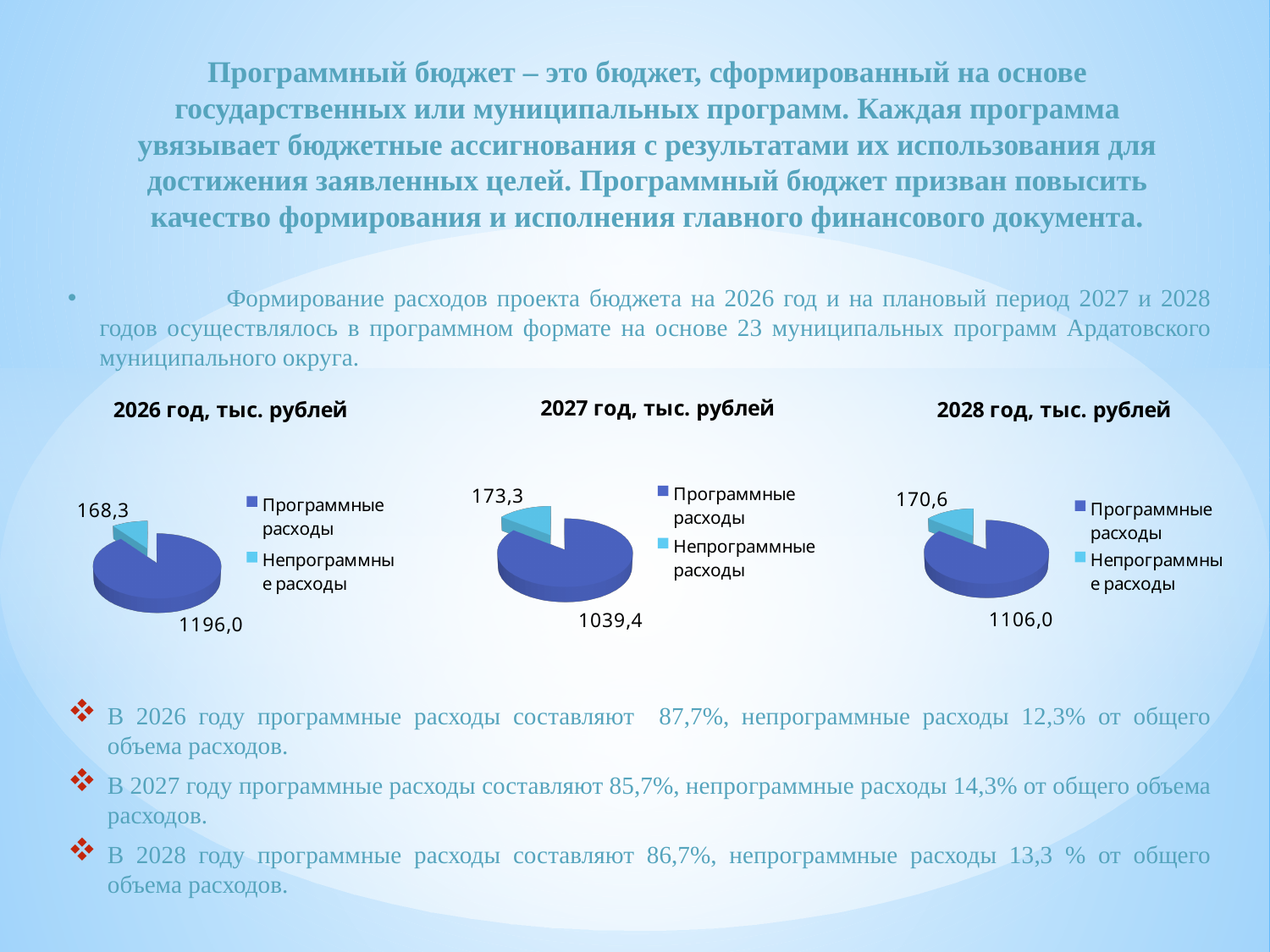
On the chart titled "2027 год, тыс. рублей", what is the value for Программные расходы? 1039,4 What kind of chart is the chart titled "2026 год, тыс. рублей"? pie chart On the chart titled "2027 год, тыс. рублей", what is the value for Непрограммные расходы? 173,3 On the chart titled "2028 год, тыс. рублей", what is the value for Программные расходы? 1106,0 How many entries does the legend of the chart titled "2027 год, тыс. рублей" list? 2 On the chart titled "2026 год, тыс. рублей", what is the value for Непрограммные расходы? 168,3 On the chart titled "2026 год, тыс. рублей", what is the difference between Программные расходы and Непрограммные расходы? 1027,7 On the chart titled "2028 год, тыс. рублей", which category has the smallest slice? Непрограммные расходы On the chart titled "2026 год, тыс. рублей", what is the value for Программные расходы? 1196,0 How many pie charts are shown on the slide? 3 On the chart titled "2027 год, тыс. рублей", which category has the largest slice? Программные расходы On the chart titled "2028 год, тыс. рублей", what is the value for Непрограммные расходы? 170,6